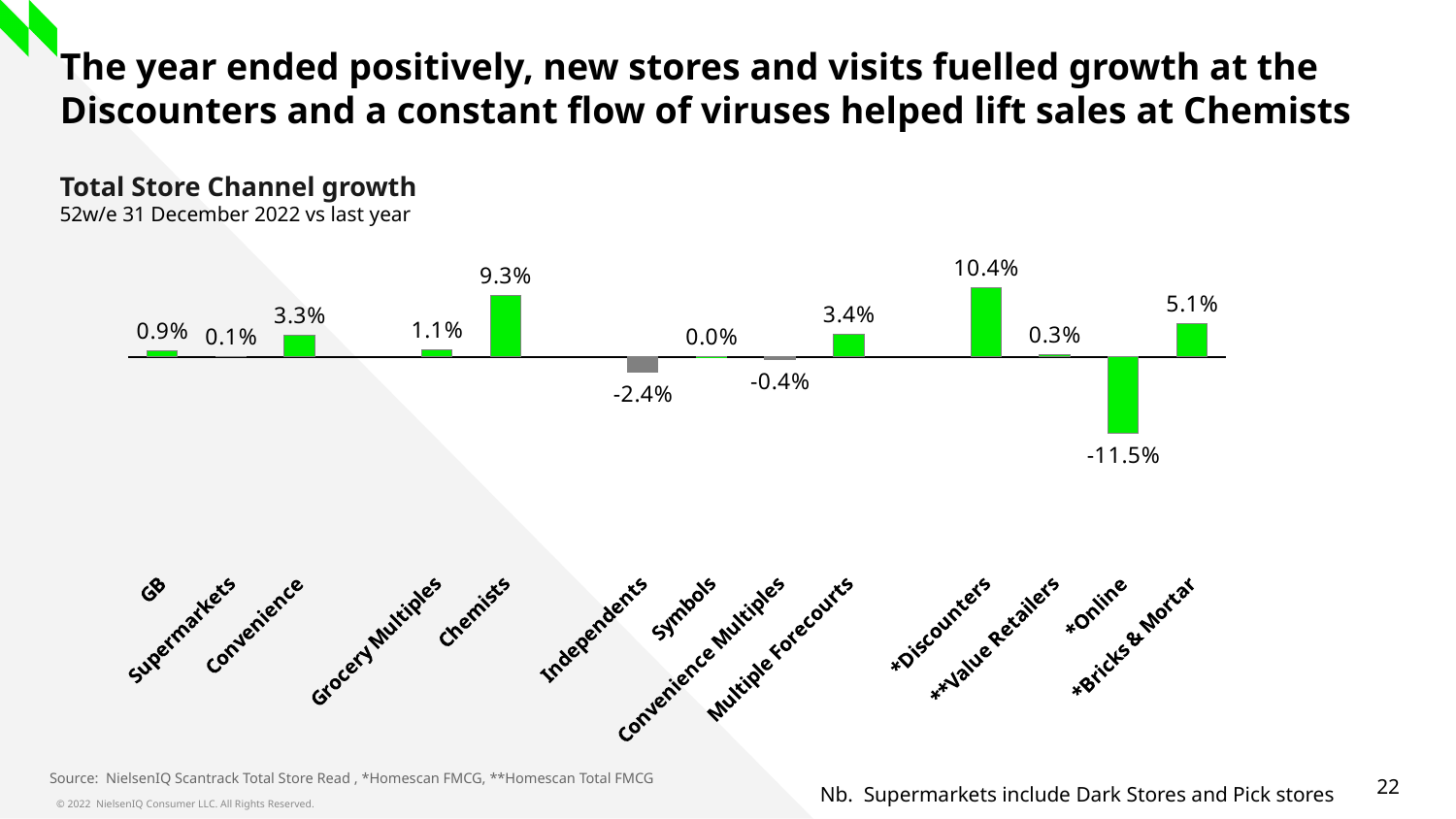
What is the growth value for Independents? -2.4% What is the growth value for Chemists? 9.3% What type of chart is shown on the slide? Bar chart What is the growth value for *Discounters? 10.4% What is the growth value for *Online? -11.5% Which has higher growth, Convenience or Multiple Forecourts? Multiple Forecourts What is the title of the chart? Total Store Channel growth What is the difference between the growth for *Discounters and Chemists? 1.1 percentage points Which channel has the lowest growth? *Online How many channels are shown in the chart? 13 Which channel has the highest growth? *Discounters What is the growth value for Symbols? 0.0%